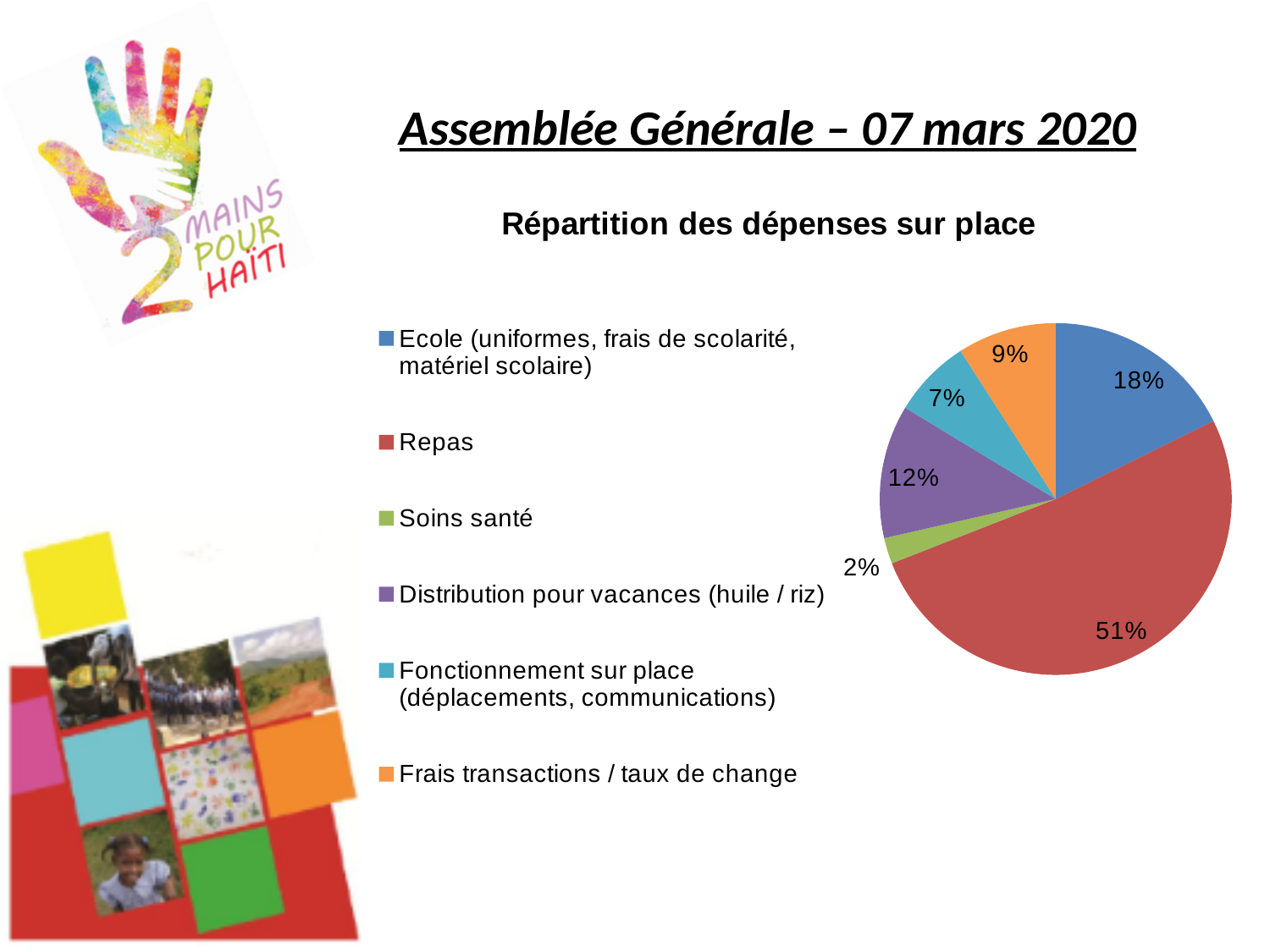
What share of the pie does Repas represent? 51% What share of the pie does Distribution pour vacances (huile / riz) represent? 12% What is the title of the chart? Répartition des dépenses sur place What is the difference in percentage points between Repas and Ecole (uniformes, frais de scolarité, matériel scolaire)? 33 What kind of chart is shown on the slide? pie chart Which category has the smallest share of the pie? Soins santé What share of the pie does Soins santé represent? 2% What share of the pie does Frais transactions / taux de change represent? 9% What share of the pie does Ecole (uniformes, frais de scolarité, matériel scolaire) represent? 18% How many categories does the legend list? 6 Which category has the largest share of the pie? Repas Which is larger: Fonctionnement sur place (déplacements, communications) or Frais transactions / taux de change? Frais transactions / taux de change